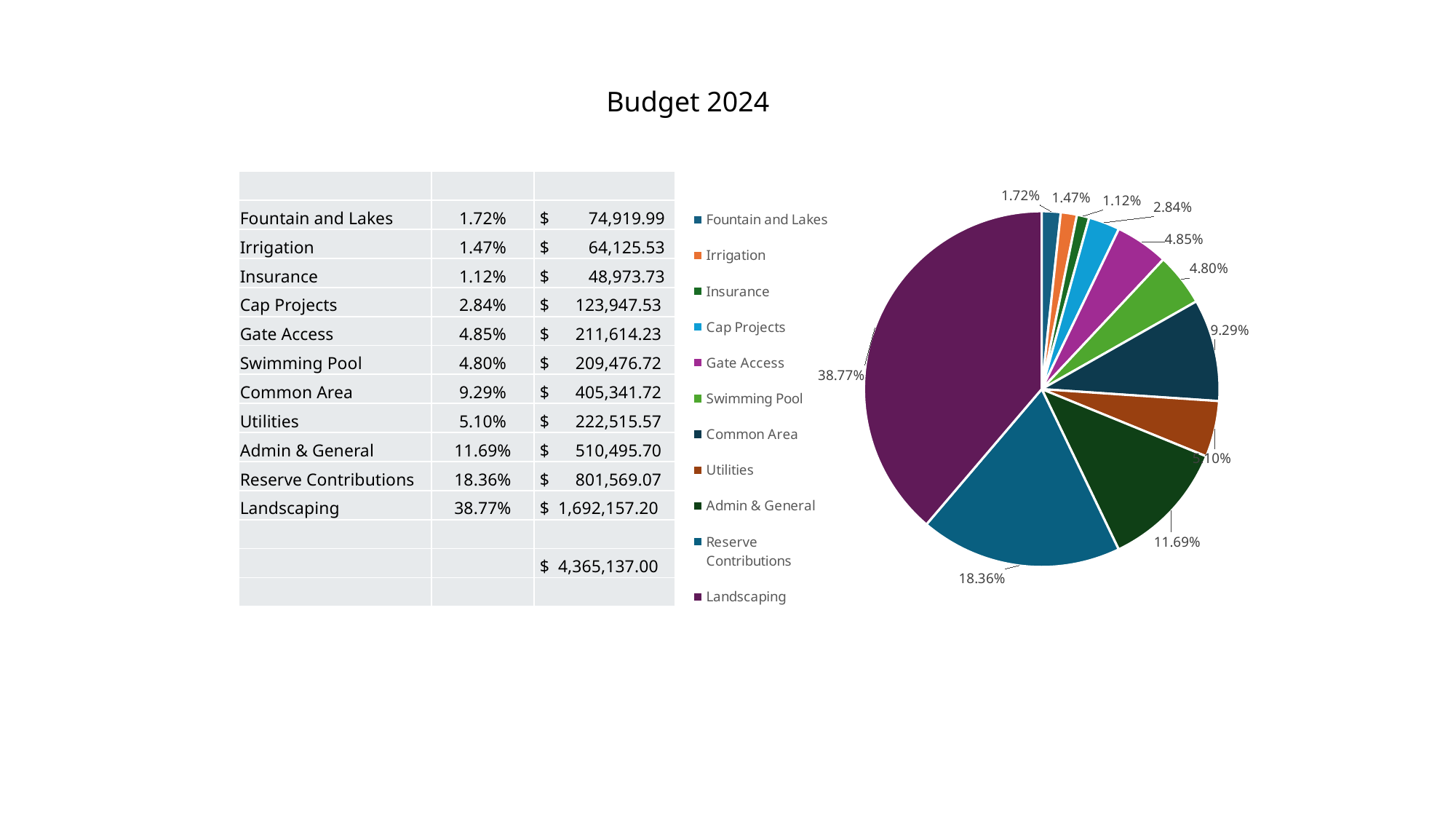
Which category has the smallest slice of the pie? Insurance What is the title of the slide containing the pie chart? Budget 2024 Which category has the largest slice of the pie? Landscaping What percentage is shown for Reserve Contributions in the pie chart? 18.36% How many slices does the pie chart have? 11 What share of the pie does Landscaping represent? 38.77% What is the difference in percentage points between Admin & General and Utilities? 6.59 What colour is the Landscaping slice in the pie chart? purple What type of chart is shown on the slide? pie chart Which slice is larger, Gate Access or Cap Projects? Gate Access How many entries does the legend list? 11 What percentage is shown for Common Area in the pie chart? 9.29%